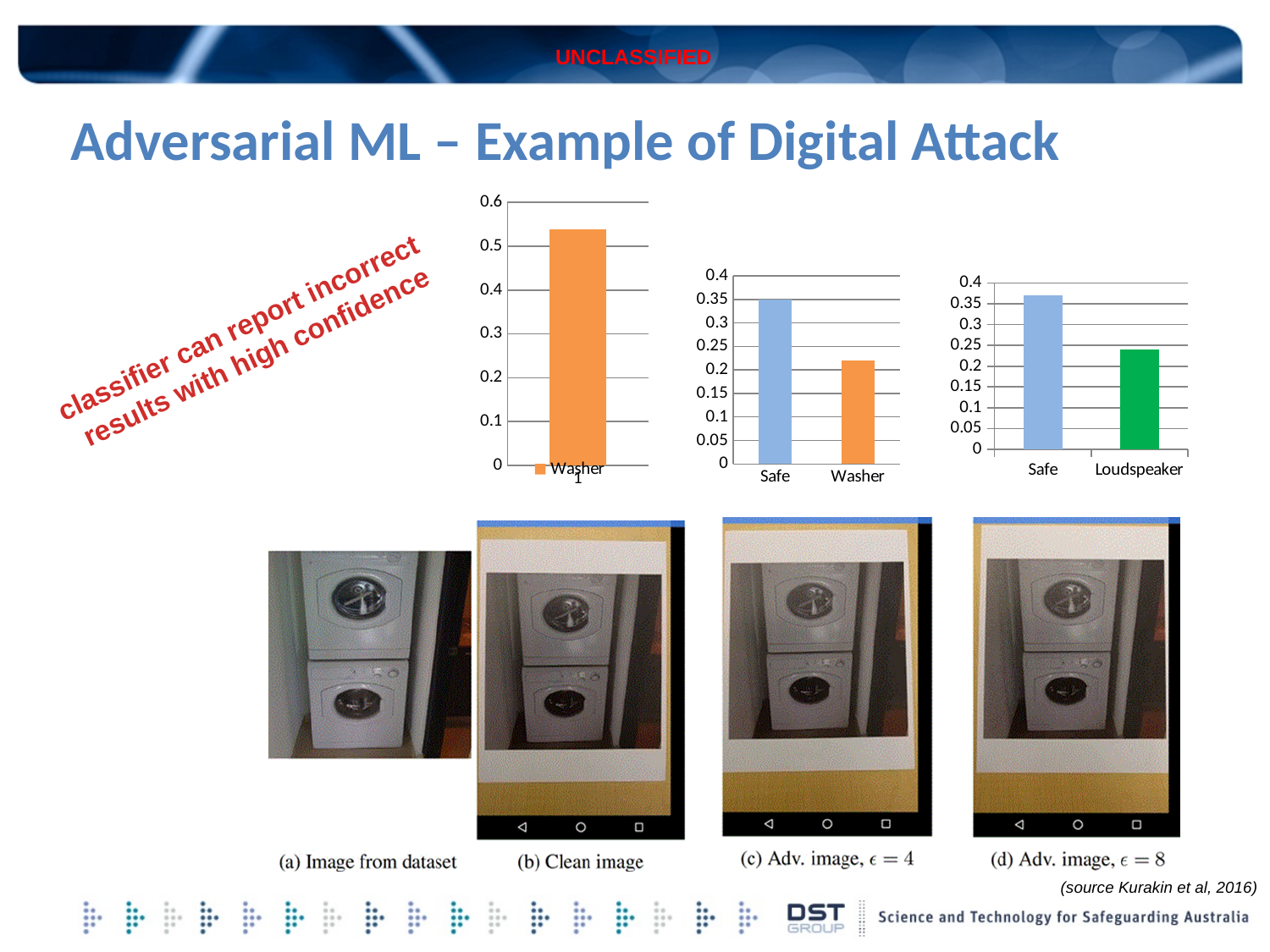
In the rightmost chart, which is larger, the value for Safe or the value for Loudspeaker? Safe In the middle chart, which category has the lowest value? Washer In the rightmost chart, is the value for Safe greater or less than 0.35? greater In the leftmost chart, is the value for Washer greater or less than 0.5? greater In the middle chart, which category has the highest value? Safe In the middle chart, is the value for Washer greater or less than 0.3? less What are the two category labels on the x axis of the rightmost chart? Safe and Loudspeaker In the leftmost chart, what is the highest value shown on the vertical axis? 0.6 How many categories are shown in the middle chart? 2 What kind of chart is the leftmost chart on the slide? bar chart